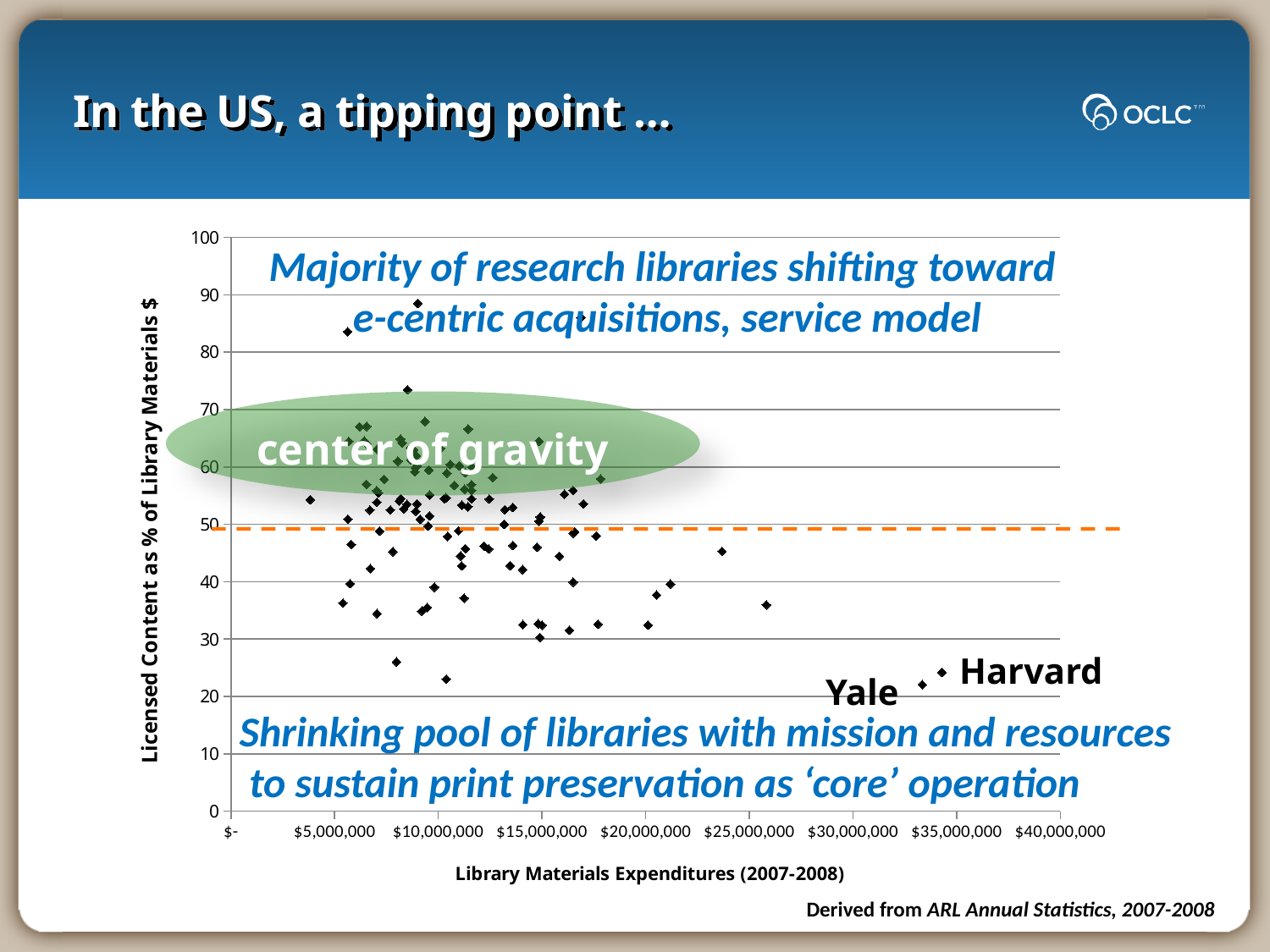
Which of the two labeled libraries, Yale or Harvard, has the higher Library Materials Expenditure? Harvard What is the title of the y axis of the chart? Licensed Content as % of Library Materials $ How many data points on the chart are labeled with a library name? 2 What kind of chart is shown on the slide? scatter chart Is the highest Licensed Content percentage plotted on the chart greater or less than 80? greater What is the title of the x axis of the chart? Library Materials Expenditures (2007-2008) Is the Library Materials Expenditure for Harvard greater or less than $30,000,000? greater Is the Library Materials Expenditure for Yale greater or less than $30,000,000? greater What is the highest value shown on the x axis of the chart? $40,000,000 What is the highest value shown on the y axis of the chart? 100